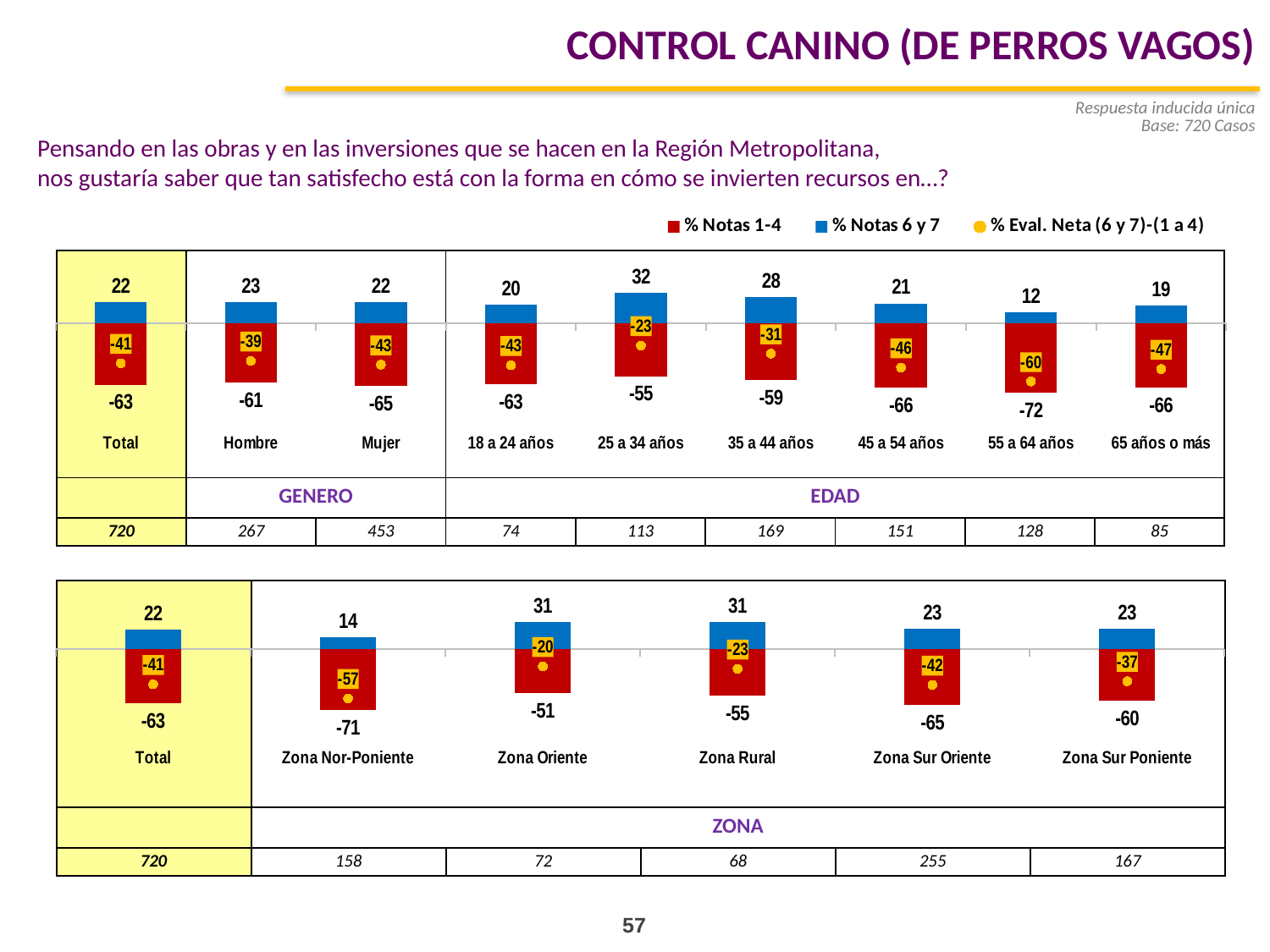
In the bottom chart, which zone has the lowest % Notas 6 y 7 value? Zona Nor-Poniente In the top chart, what is the % Eval. Neta value for Mujer? -43 In the bottom chart, what is the % Eval. Neta value for Zona Nor-Poniente? -57 In the top chart, what is the difference between the % Notas 6 y 7 values for Hombre and 55 a 64 años? 11 In the top chart, which age group has the lowest % Notas 6 y 7 value? 55 a 64 años In the bottom chart, is the % Notas 6 y 7 value for Zona Rural larger or smaller than that for Zona Sur Oriente? larger What type of chart is the bottom chart? bar chart In the bottom chart, what is the % Notas 1-4 value for Zona Oriente? -51 How many series does the legend list? 3 In the top chart, what is the % Notas 6 y 7 value for 25 a 34 años? 32 In the top chart, what is the % Notas 1-4 value for 55 a 64 años? -72 In the top chart, which age group has the highest % Notas 6 y 7 value? 25 a 34 años